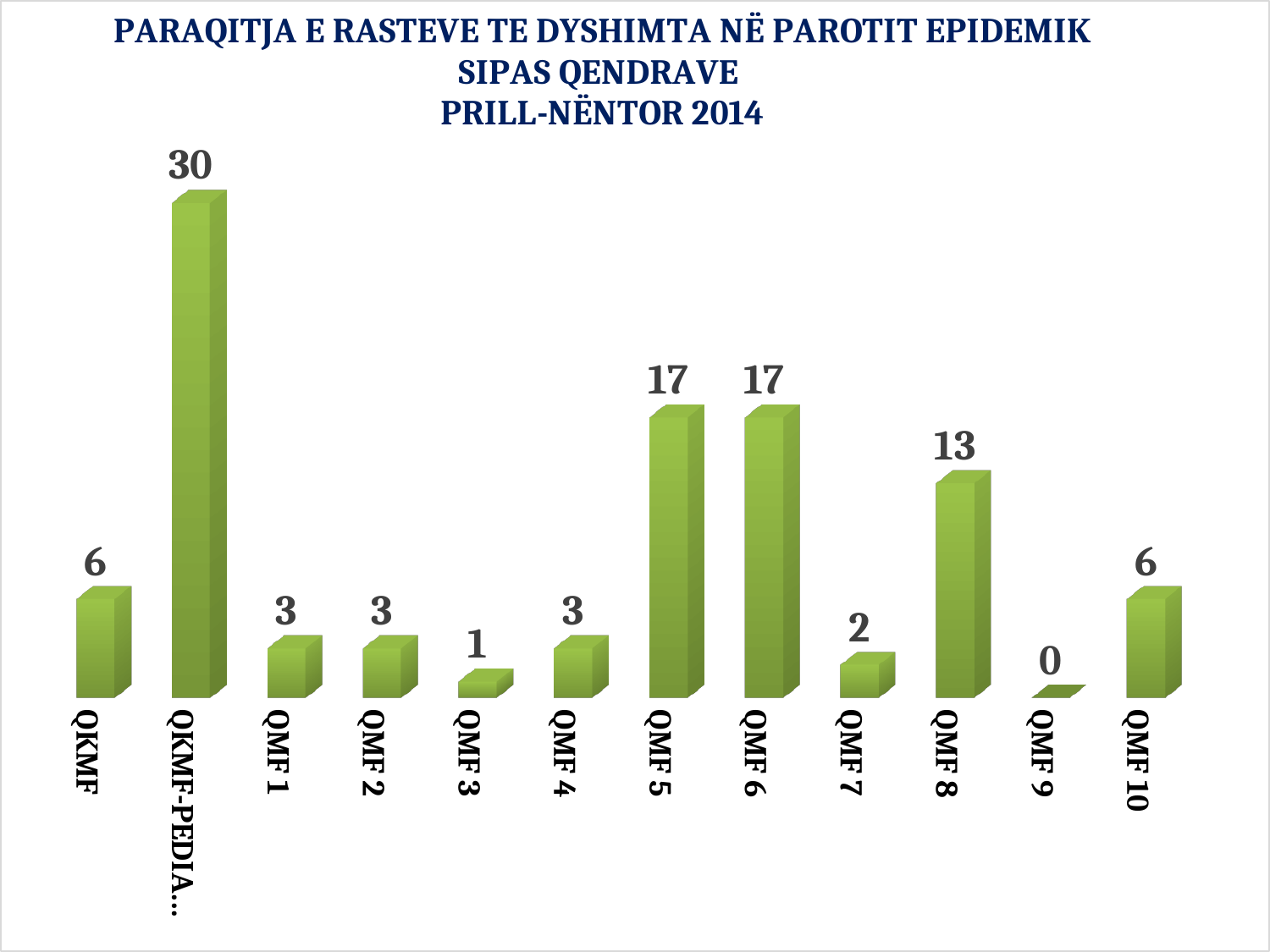
What is the value for QMF 3? 1 What kind of chart is shown on the slide? bar chart What is the value for QMF 8? 13 Which is larger, the value for QMF 7 or the value for QMF 10? QMF 10 Which category has the highest value? QKMF-PEDIA... What is the difference between the values for QMF 5 and QMF 8? 4 What period does the chart title refer to? PRILL-NËNTOR 2014 Which category has the lowest value? QMF 9 How many categories are shown on the x axis? 12 What is the value for QKMF? 6 What is the value for QMF 9? 0 What is the difference between the values for QKMF-PEDIA... and QMF 6? 13